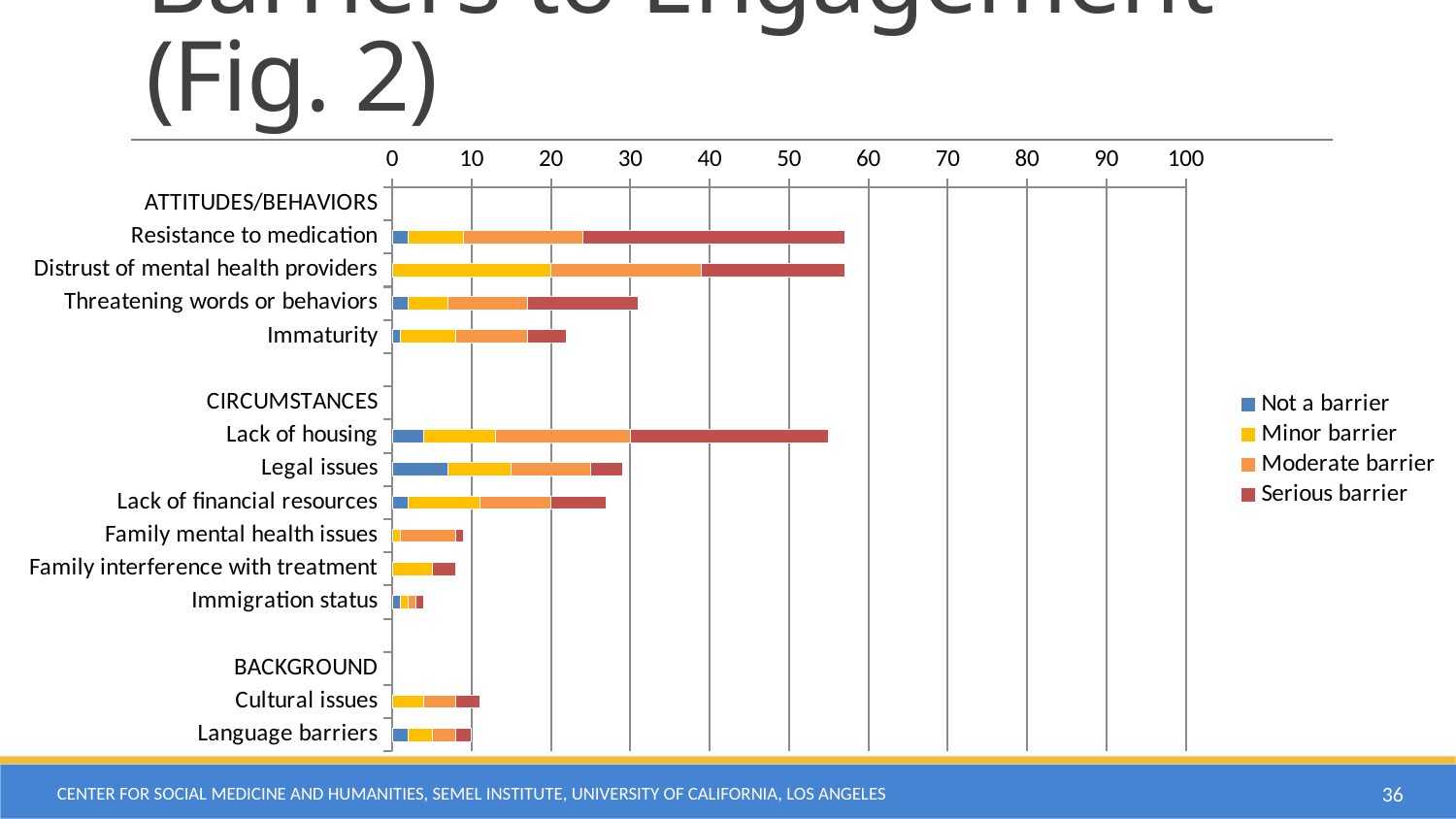
Is the total value for Immaturity greater or less than 30? less Which legend entry is shown in red? Serious barrier How many series does the legend list? 4 Which barrier has the lowest total bar length? Immigration status What kind of chart is shown on the slide? Stacked bar chart Which has the larger total bar, Legal issues or Family mental health issues? Legal issues How many individual barriers (excluding the group headings) have bars plotted? 12 Is the total value for Lack of housing greater or less than 50? greater Is the total value for Resistance to medication greater or less than 50? greater Which has the larger total bar, Lack of housing or Immaturity? Lack of housing